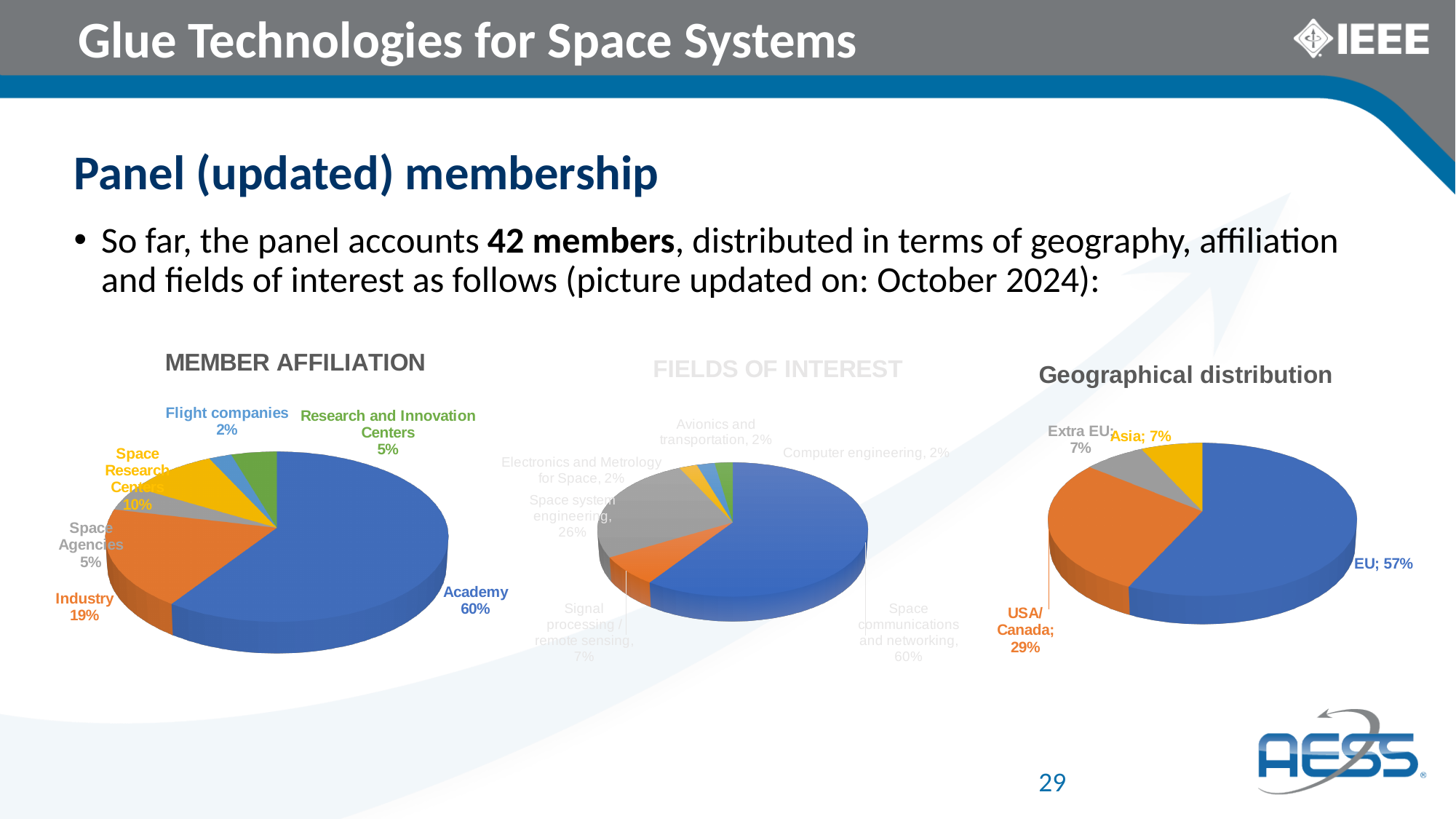
In the FIELDS OF INTEREST chart, what share is Space communications and networking? 60% In the MEMBER AFFILIATION chart, what is the difference between the Industry share and the Space Research Centers share? 9% In the MEMBER AFFILIATION chart, how many affiliation categories are shown? 6 In the Geographical distribution chart, what share of members are from the EU? 57% In the Geographical distribution chart, which region has the largest share? EU In the Geographical distribution chart, how many regions are shown? 4 In the MEMBER AFFILIATION chart, which affiliation has the smallest share? Flight companies In the MEMBER AFFILIATION chart, what share of members are from Academy? 60% In the Geographical distribution chart, what share of members are from USA/Canada? 29% In the FIELDS OF INTEREST chart, which is larger: Space system engineering or Signal processing / remote sensing? Space system engineering What type of chart is the Geographical distribution chart? Pie chart In the MEMBER AFFILIATION chart, what share of members are from Industry? 19%